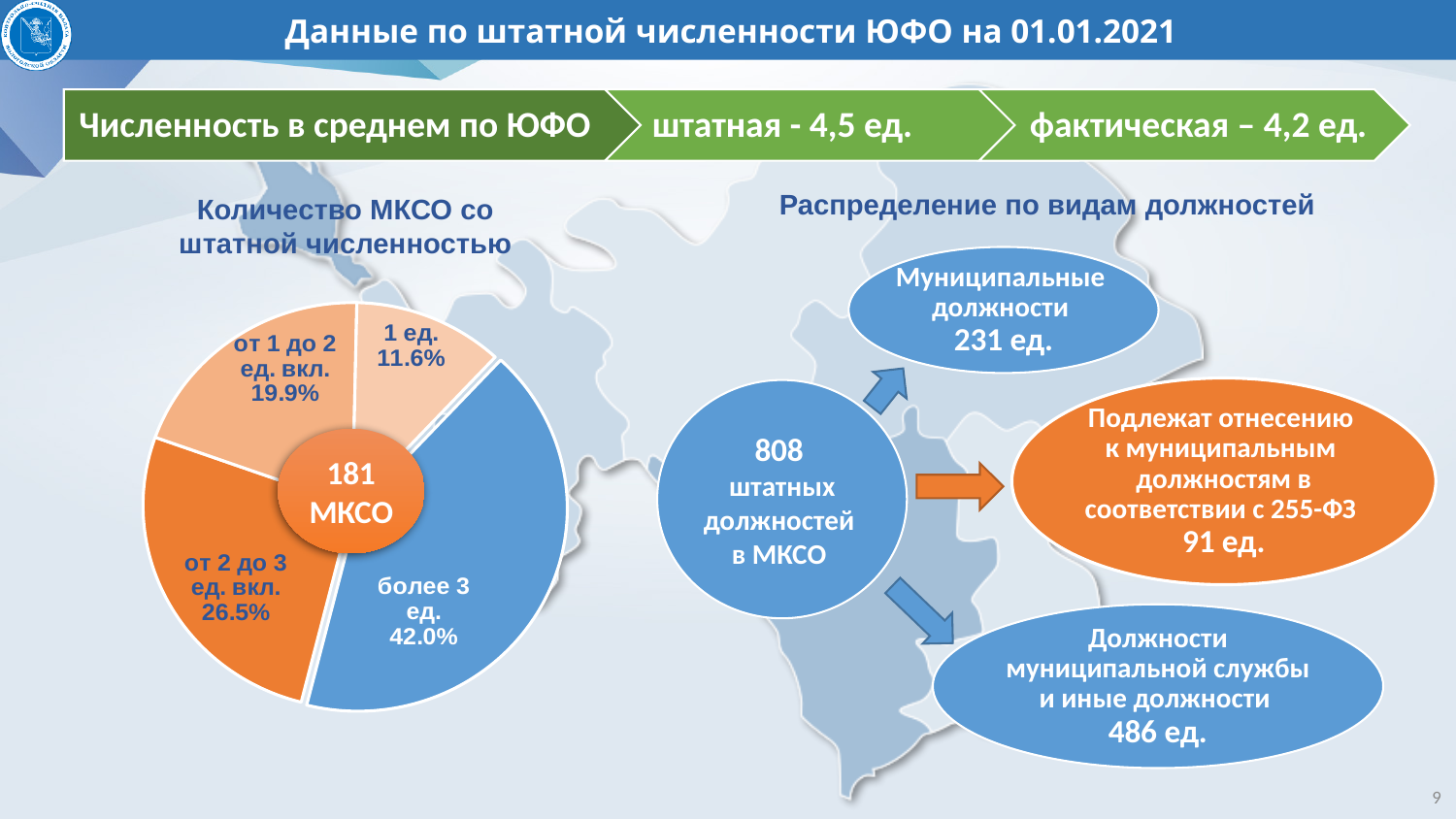
In the pie chart, what share is shown for "более 3 ед."? 42.0% In the pie chart, what share is shown for "от 2 до 3 ед. вкл."? 26.5% What is the title of the pie chart on the left of the slide? Количество МКСО со штатной численностью In the pie chart, what share is shown for "от 1 до 2 ед. вкл."? 19.9% Which slice of the pie chart is the smallest? 1 ед. How many slices does the pie chart "Количество МКСО со штатной численностью" have? 4 What kind of chart is "Количество МКСО со штатной численностью"? pie chart In the pie chart, what share is shown for "1 ед."? 11.6% What number is shown in the centre of the pie chart? 181 МКСО In the pie chart, what is the difference in percentage points between "более 3 ед." and "от 2 до 3 ед. вкл."? 15.5 Which slice of the pie chart is the largest? более 3 ед. In the pie chart, which is larger: "от 1 до 2 ед. вкл." or "от 2 до 3 ед. вкл."? от 2 до 3 ед. вкл.